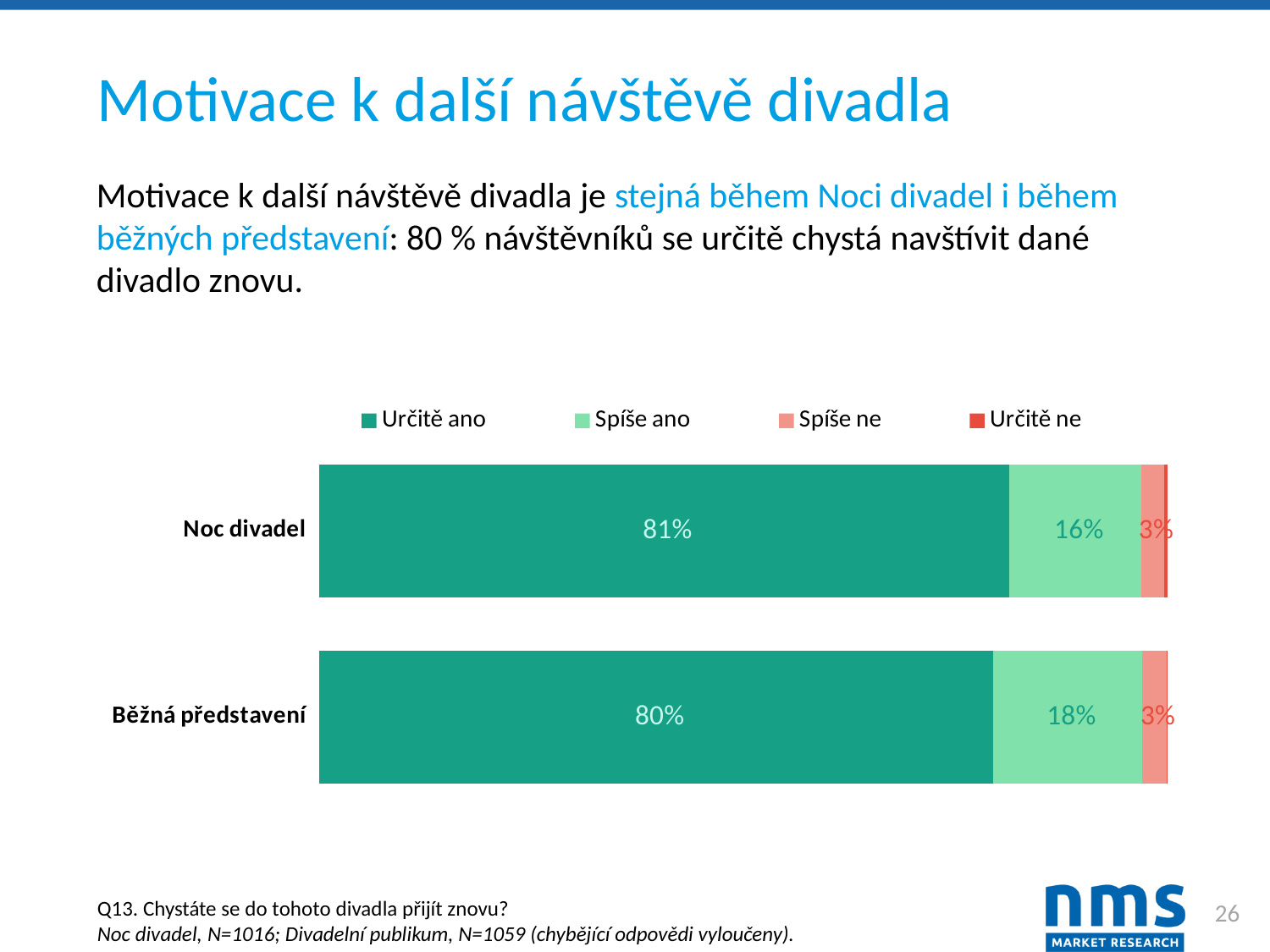
How many series does the legend list? 4 What is the value of "Určitě ano" for Noc divadel? 81% Which category has the higher "Spíše ano" value, Noc divadel or Běžná představení? Běžná představení What kind of chart is shown on the slide? Stacked bar chart What is the value of "Určitě ano" for Běžná představení? 80% What is the difference in percentage points between the "Určitě ano" values for Noc divadel and Běžná představení? 1 percentage point Which legend entry is shown in the darkest green colour? Určitě ano What is the value of "Spíše ne" for Noc divadel? 3% What is the value of "Spíše ano" for Běžná představení? 18% How many categories (bars) does the chart show? 2 What is the difference in percentage points between the "Spíše ano" values for Běžná představení and Noc divadel? 2 percentage points What is the value of "Spíše ano" for Noc divadel? 16%